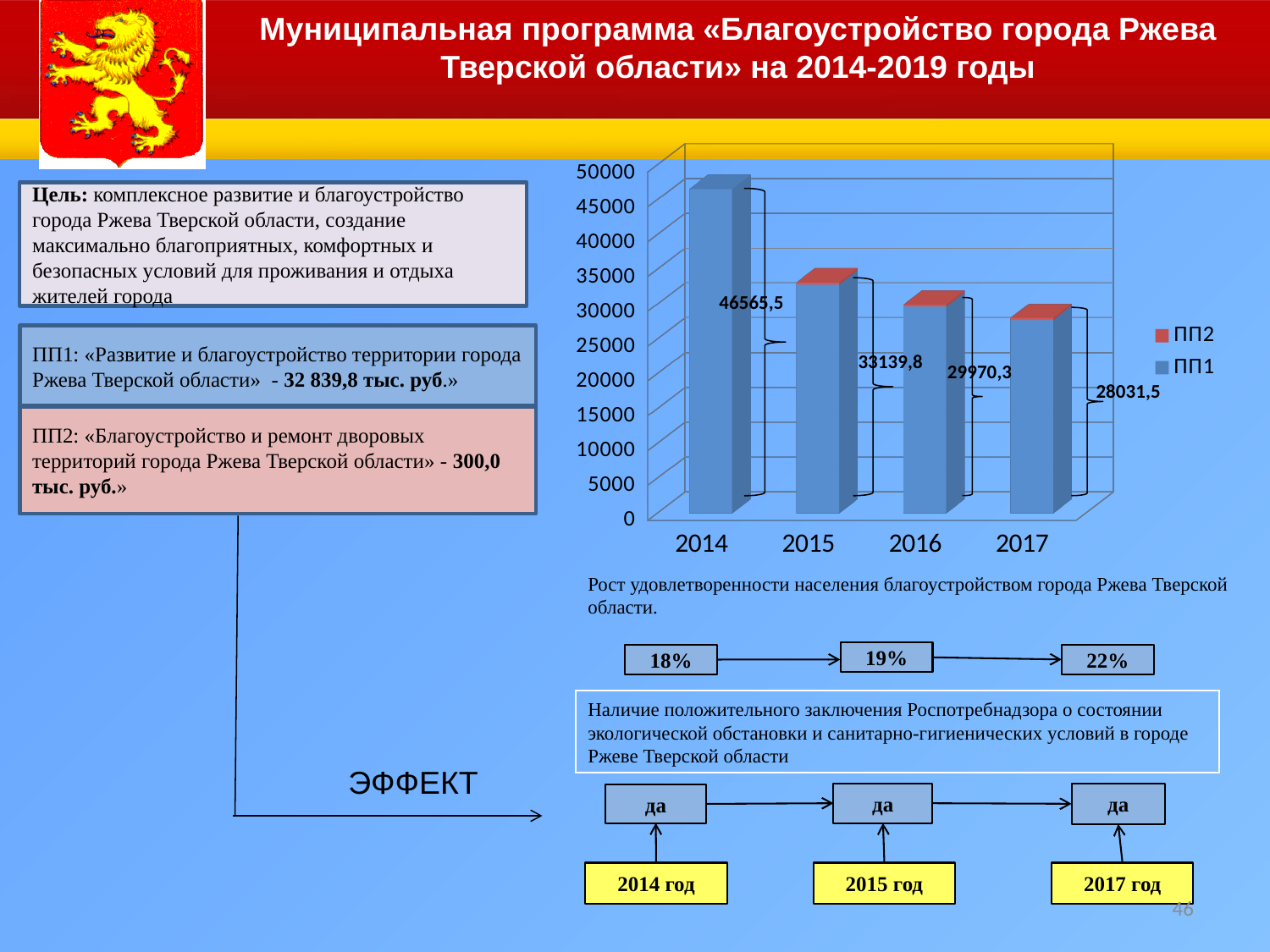
Do the bar values rise or fall from 2014 to 2017? fall What value is labelled on the bar for 2014? 46565,5 What is the difference between the labelled values for 2015 and 2016? 3169,5 How many years are shown on the x axis of the chart? 4 How many series does the chart legend list? 2 Which year has the lowest bar in the chart? 2017 Which year has the highest bar in the chart? 2014 What kind of chart is shown on the slide? bar chart What value is labelled on the bar for 2016? 29970,3 Which bar is taller, 2015 or 2016? 2015 What value is labelled on the bar for 2017? 28031,5 Which series is shown in red in the chart legend? ПП2